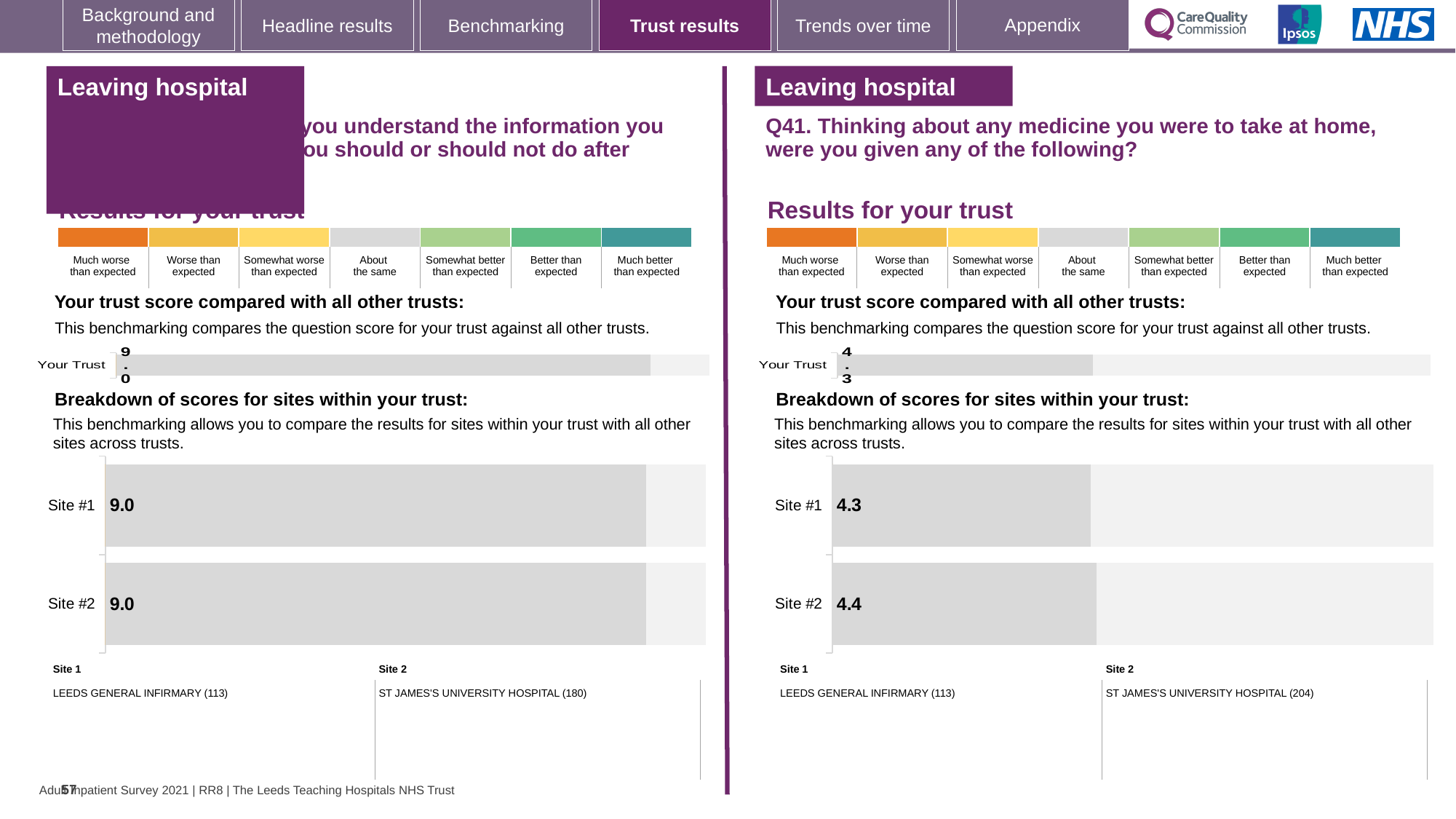
On the right-hand chart (Q41), what is the score for Site #1? 4.3 On the left-hand chart, which hospital is Site 1? LEEDS GENERAL INFIRMARY (113) On the right-hand chart (Q41), which site has the higher score, Site #1 or Site #2? Site #2 How many sites are shown in the site breakdown chart on the right-hand side (Q41)? 2 On the right-hand chart (Q41), what is the difference between the Site #2 score and the Site #1 score? 0.1 What type of chart is used to show the breakdown of scores for sites on the left-hand side? Bar chart On the left-hand chart, what is the score for Site #1? 9.0 On the right-hand chart (Q41), which hospital is Site 2? ST JAMES'S UNIVERSITY HOSPITAL (204) On the left-hand chart, what is the 'Your Trust' score? 9.0 On the right-hand chart (Q41), what is the score for Site #2? 4.4 On the right-hand chart (Q41), what is the 'Your Trust' score? 4.3 On the left-hand chart, what is the score for Site #2? 9.0